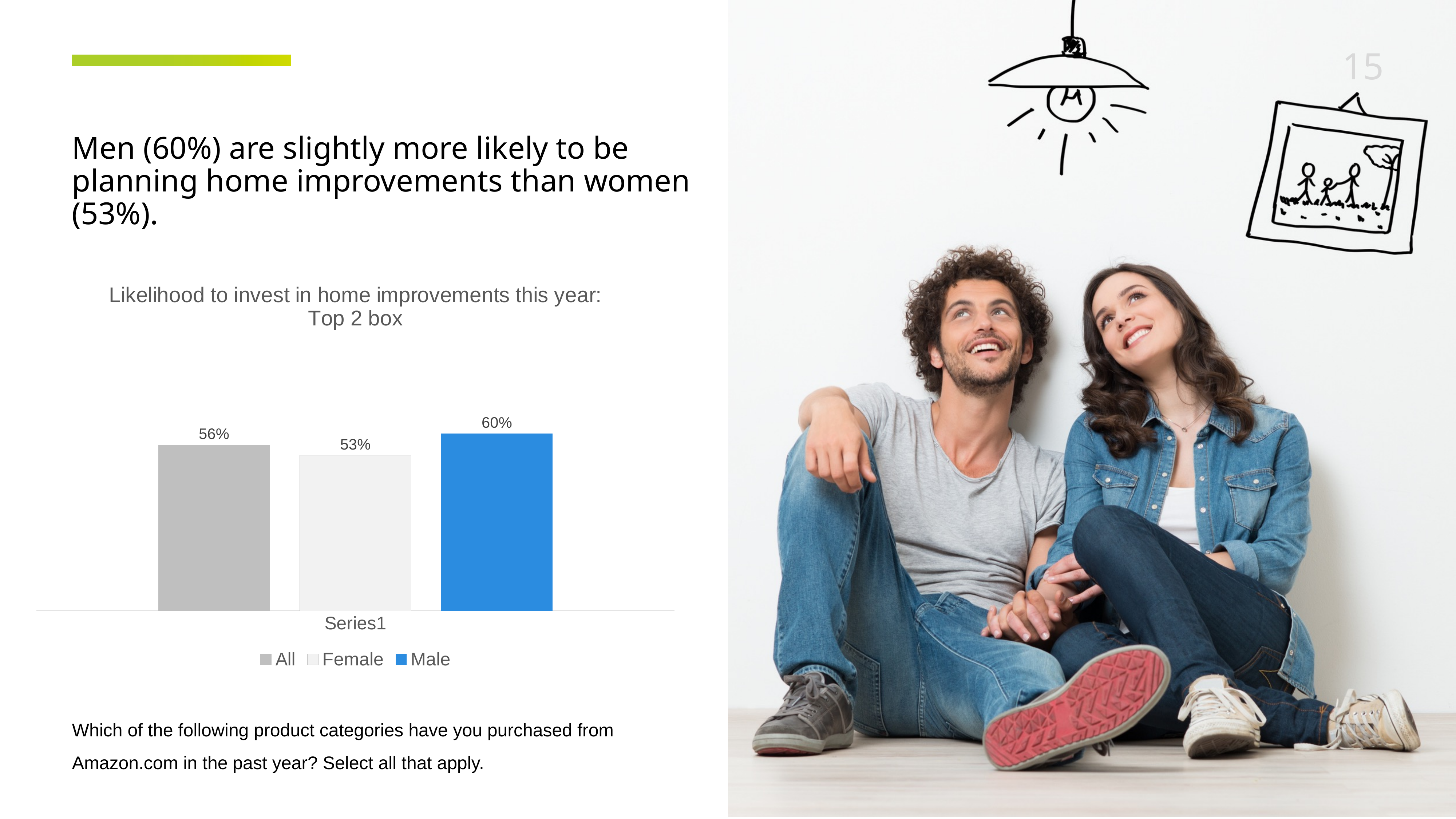
What is the value for Male in the chart? 60% What kind of chart is shown on the slide? Bar chart What is the difference between the Male and Female values? 7% Which series has the lowest value in the chart? Female What is the title of the chart? Likelihood to invest in home improvements this year: Top 2 box What is the value for All in the chart? 56% What is the value for Female in the chart? 53% What colour is the Male bar in the chart? Blue What is the difference between the All and Female values? 3% Which is larger, the value for Male or the value for All? Male Which series has the highest value in the chart? Male How many series does the legend list? 3